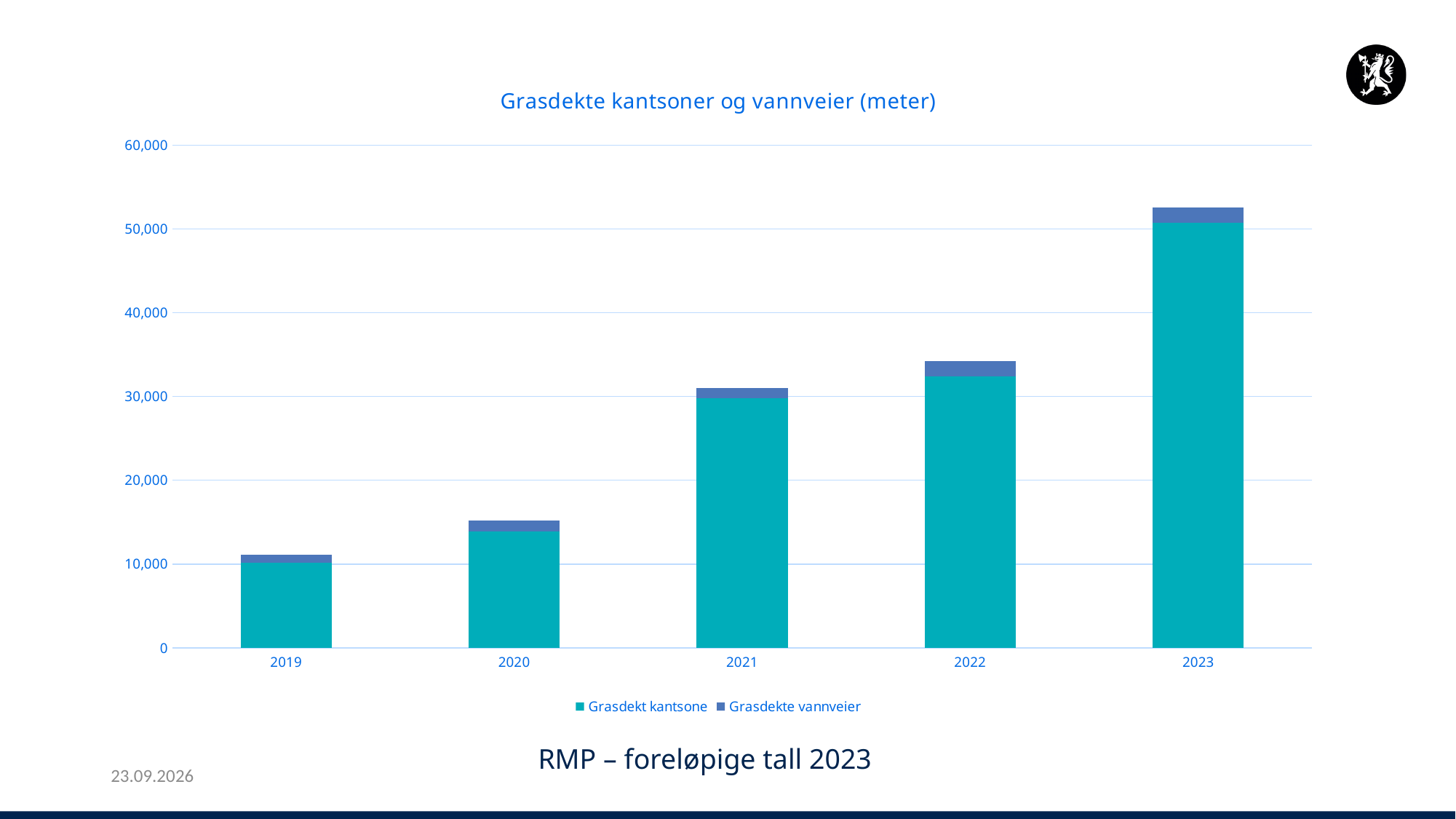
What is the title of the chart? Grasdekte kantsoner og vannveier (meter) What kind of chart is shown on the slide? Stacked bar chart Which year has the highest total bar? 2023 Which series is shown in the darker blue colour at the top of each bar? Grasdekte vannveier How many series does the legend list? 2 Is the total bar for 2023 greater or less than 50,000? greater How many years are shown on the x axis? 5 Which year has the larger total bar, 2021 or 2022? 2022 Which year has the lowest total bar? 2019 Is the Grasdekt kantsone value for 2022 greater or less than 30,000? greater Is the total bar for 2020 greater or less than 20,000? less Do the total bar heights rise or fall from 2019 to 2023? Rise